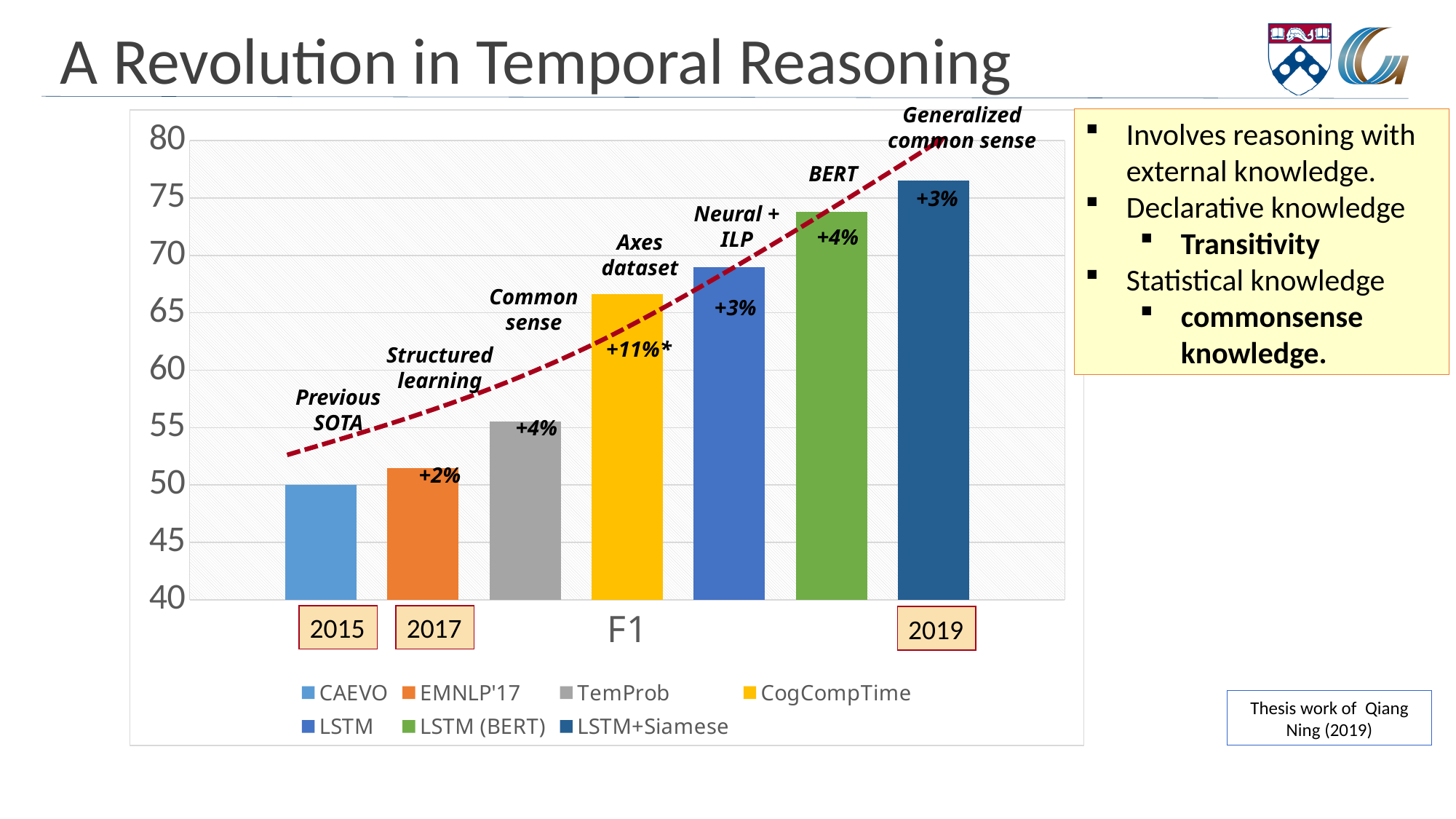
Is the F1 value for TemProb greater or less than 60? less Which series has the lowest F1 bar? CAEVO Which series has the highest F1 bar? LSTM+Siamese What improvement label is printed on the CogCompTime bar? +11%* How many series does the chart's legend list? 7 Is the F1 value for LSTM greater or less than 70? less Which bar is taller, LSTM (BERT) or LSTM? LSTM (BERT) Is the F1 value for CogCompTime greater or less than 65? greater What kind of chart is shown on the slide? bar chart Do the F1 bars rise or fall from left to right across the chart? rise What label is shown on the horizontal axis of the chart? F1